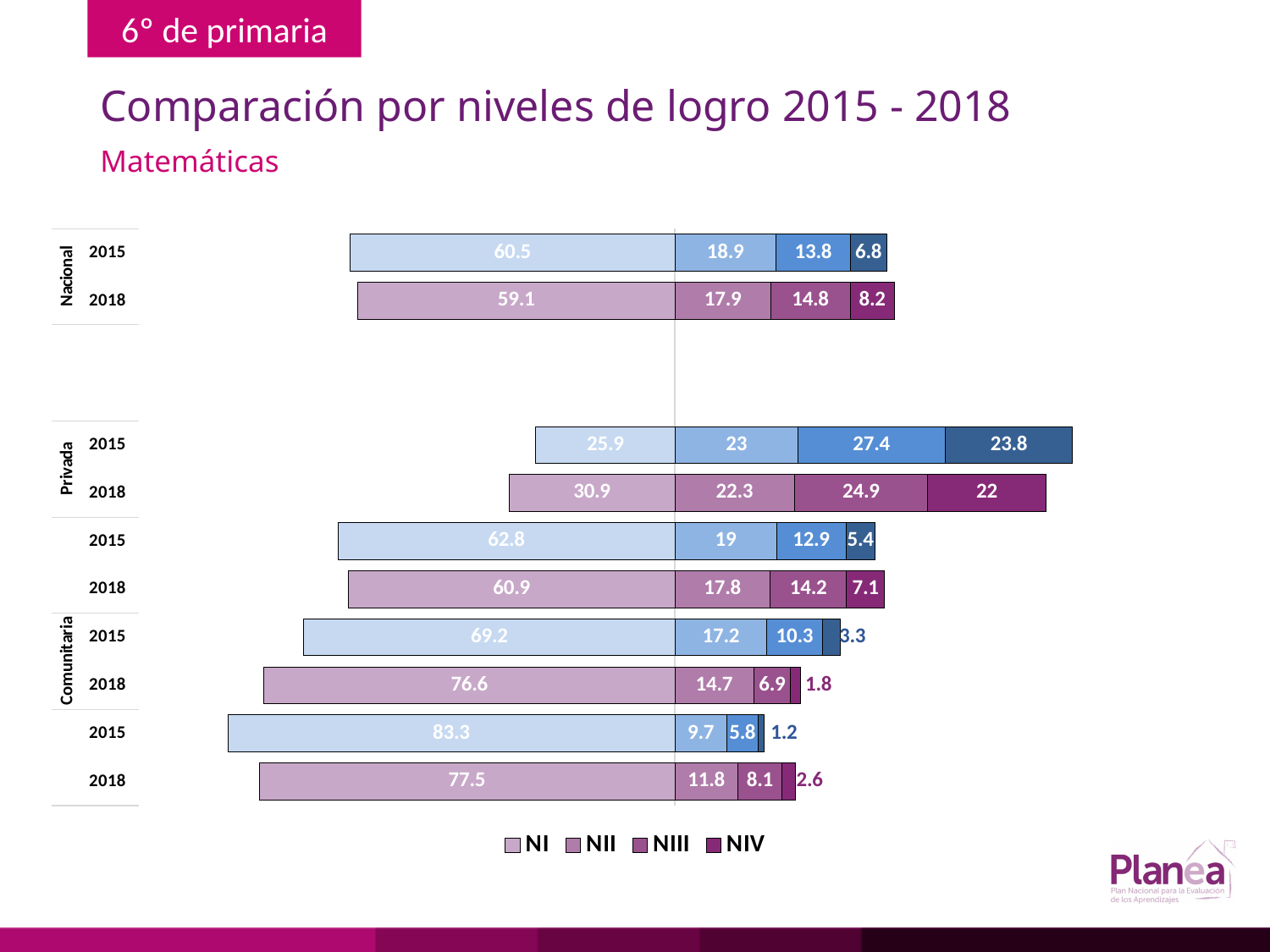
What is the value for NI in the Privada 2018 bar? 30.9 What is the difference between the NI values for Nacional 2015 and Nacional 2018? 1.4 What is the total of the Nacional 2015 stacked bar? 100 What kind of chart is shown on the slide? Stacked bar chart What is the value for NI in the Nacional 2015 bar? 60.5 What is the value for NIV in the Nacional 2018 bar? 8.2 What is the value for NIII in the Privada 2015 bar? 27.4 Which is larger, the NIV value for Privada 2015 or for Privada 2018? Privada 2015 What is the value for NII in the Comunitaria 2018 bar? 14.7 How many series does the legend list? 4 What is the difference between the NIV values for Privada 2015 and Privada 2018? 1.8 Within the Privada 2015 bar, which level has the largest value? NIII